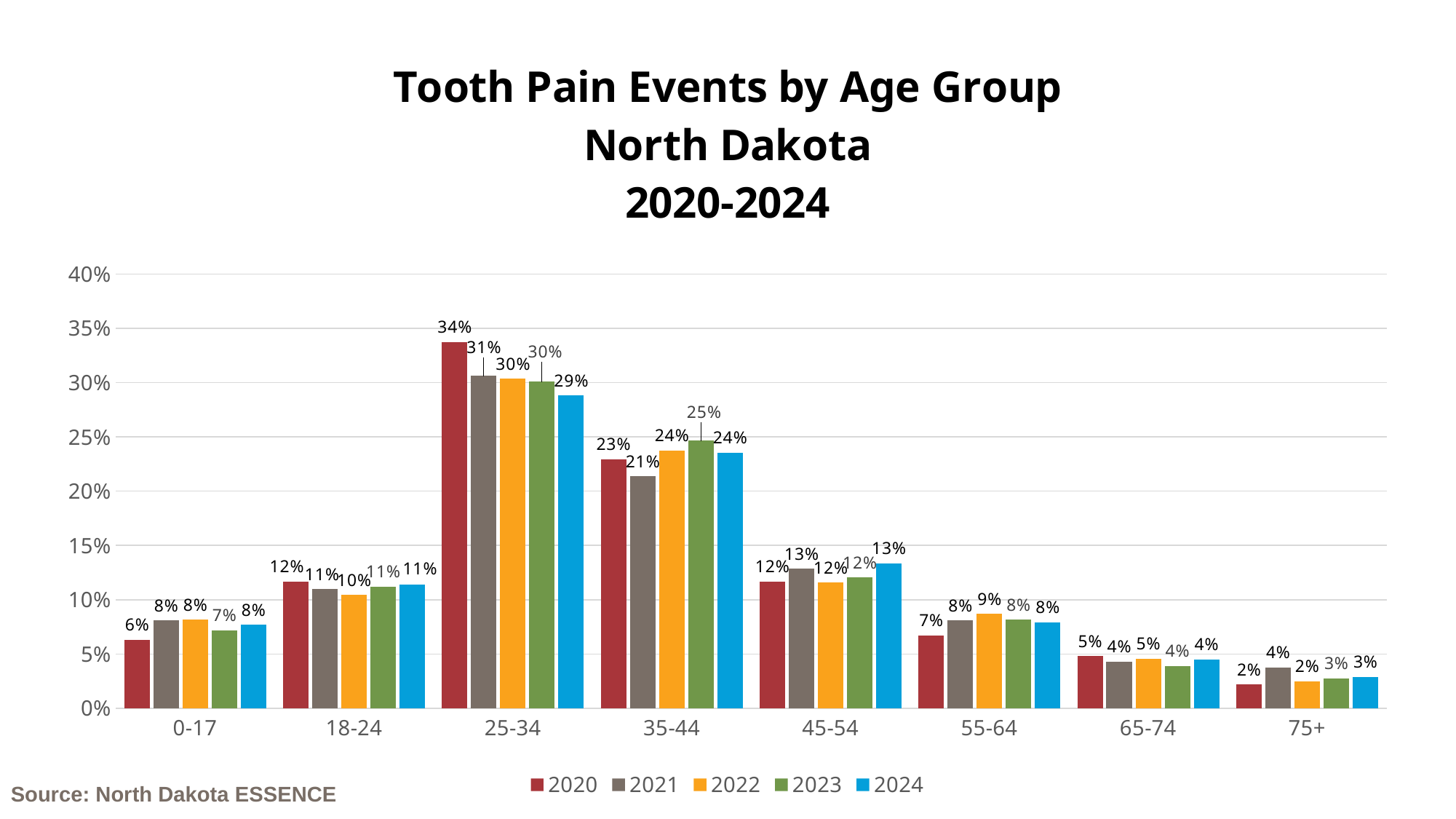
What is the value for the 25-34 age group in 2020? 34% What is the value for the 35-44 age group in 2023? 25% What is the difference between the 2020 and 2024 values for the 25-34 age group? 5% How many age groups are shown on the x axis? 8 What kind of chart is shown on the slide? Bar chart Which is larger for the 35-44 age group: the 2020 value or the 2021 value? 2020 Which age group has the highest value in 2024? 25-34 How many series does the legend list? 5 What is the value for the 0-17 age group in 2020? 6% Which age group has the lowest value in 2020? 75+ What is the source cited at the bottom of the slide? North Dakota ESSENCE Do the 2020 values rise or fall from the 35-44 age group to the 75+ age group? Fall